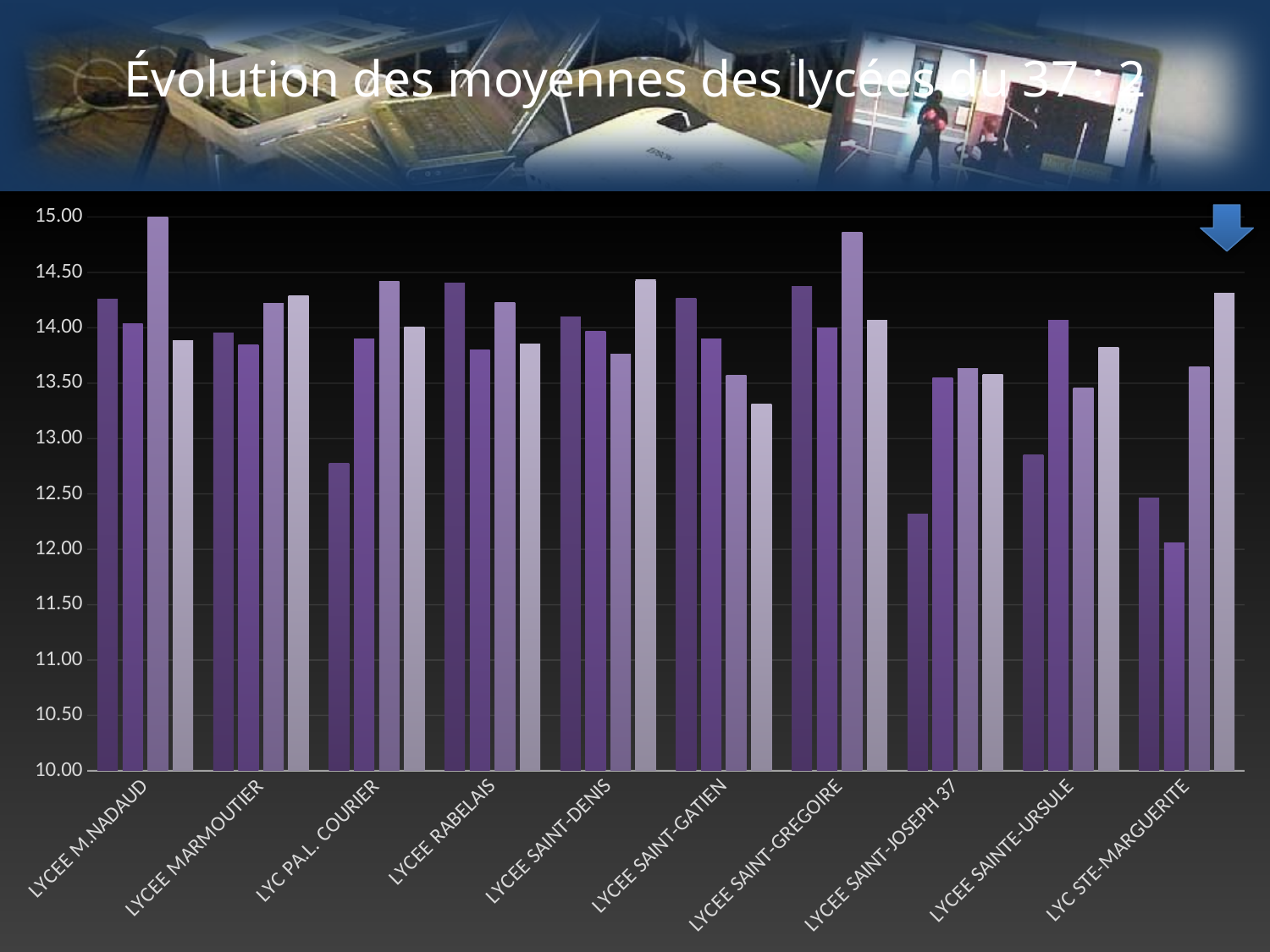
Is the value of the second bar for LYC STE-MARGUERITE greater or less than 12.50? less Is the value of the third bar for LYCEE SAINT-GREGOIRE greater or less than 14.50? greater For LYC STE-MARGUERITE, which is larger: the first bar or the fourth bar? the fourth bar What are the lowest and highest values shown on the chart's vertical axis? 10.00 and 15.00 Which lycée has the lowest bar in the whole chart? LYC STE-MARGUERITE How many bars are plotted for each lycée in the chart? 4 What kind of chart is shown on the slide? bar chart How many lycées (categories) are shown on the x axis of the chart? 10 Is the value of the first bar for LYC PA.L. COURIER greater or less than 13.00? less What is the title of the slide containing the chart? Évolution des moyennes des lycées du 37 : 2